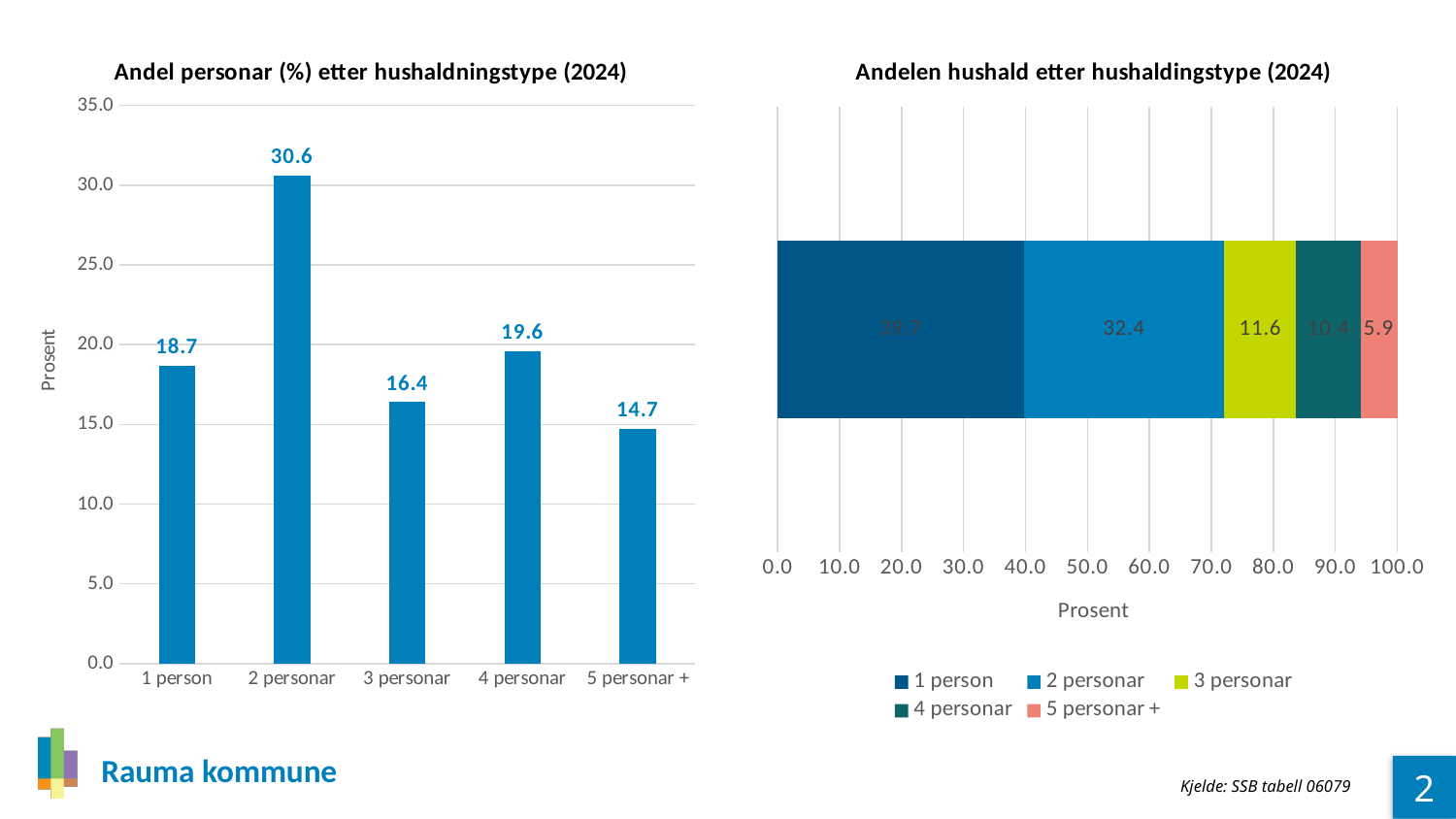
In the chart 'Andel personar (%) etter hushaldningstype (2024)', what is the difference between the values for 2 personar and 1 person? 11.9 How many series does the legend of the chart 'Andelen hushald etter hushaldingstype (2024)' list? 5 In the chart 'Andel personar (%) etter hushaldningstype (2024)', which is larger, the value for 4 personar or 3 personar? 4 personar In the chart 'Andelen hushald etter hushaldingstype (2024)', what is the total of the stacked bar? 100.0 In the chart 'Andel personar (%) etter hushaldningstype (2024)', which category has the highest value? 2 personar In the chart 'Andel personar (%) etter hushaldningstype (2024)', what is the value for 5 personar +? 14.7 What kind of chart is 'Andel personar (%) etter hushaldningstype (2024)'? Bar chart How many categories are shown on the x axis of the chart 'Andel personar (%) etter hushaldningstype (2024)'? 5 In the chart 'Andelen hushald etter hushaldingstype (2024)', what is the value for 3 personar? 11.6 In the chart 'Andel personar (%) etter hushaldningstype (2024)', which category has the lowest value? 5 personar + In the chart 'Andelen hushald etter hushaldingstype (2024)', what is the value for 2 personar? 32.4 In the chart 'Andel personar (%) etter hushaldningstype (2024)', what is the value for 2 personar? 30.6